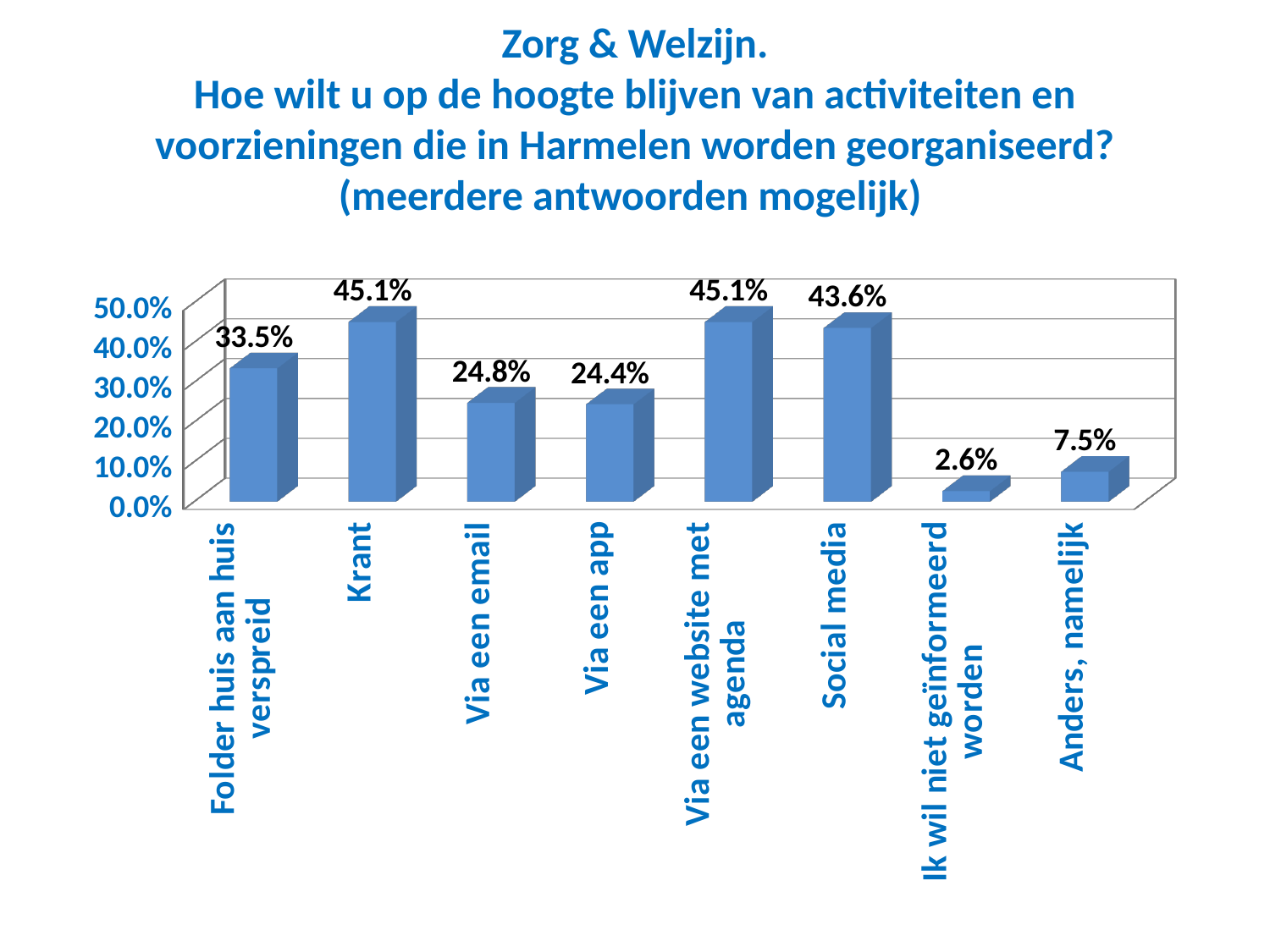
What is the value for Folder huis aan huis verspreid? 33.5% What is the value for Via een app? 24.4% What is the difference between the values for Krant and Social media? 1.5% Which category has the lowest value? Ik wil niet geïnformeerd worden What is the value for Social media? 43.6% What is the value for Anders, namelijk? 7.5% Which is larger, the value for Folder huis aan huis verspreid or the value for Via een email? Folder huis aan huis verspreid What kind of chart is shown on the slide? Bar chart What is the difference between the values for Via een email and Via een app? 0.4% How many categories are shown in the chart? 8 Which two categories share the highest value? Krant and Via een website met agenda What is the highest value shown on the vertical axis? 50.0%